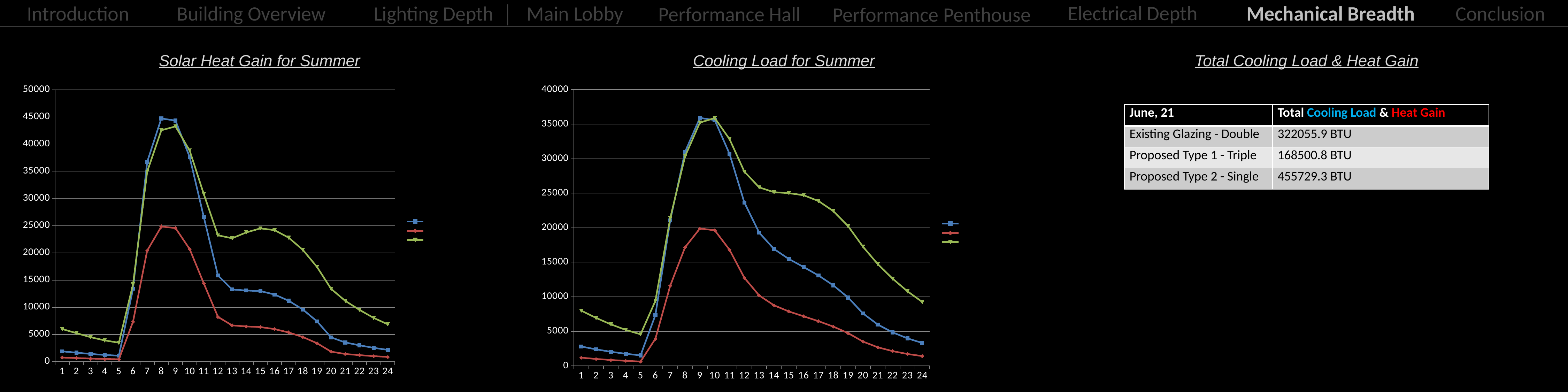
In the "Solar Heat Gain for Summer" chart, is the red series value at hour 8 greater or less than 30000? less How many series does the legend of the "Cooling Load for Summer" chart list? 3 What kind of chart is the "Solar Heat Gain for Summer" chart? line chart In the "Solar Heat Gain for Summer" chart, is the green series value at hour 15 greater or less than 20000? greater In the "Cooling Load for Summer" chart, is the red series peak value greater or less than 25000? less In the "Cooling Load for Summer" chart, does the blue series rise or fall from hour 12 to hour 24? fall In the "Cooling Load for Summer" chart, which series has the highest value at hour 1? the green series In the "Solar Heat Gain for Summer" chart, which series has the lowest peak value? the red series How many points are plotted along the x axis of the "Solar Heat Gain for Summer" chart? 24 In the "Solar Heat Gain for Summer" chart, at hour 15, is the green series or the blue series higher? the green series